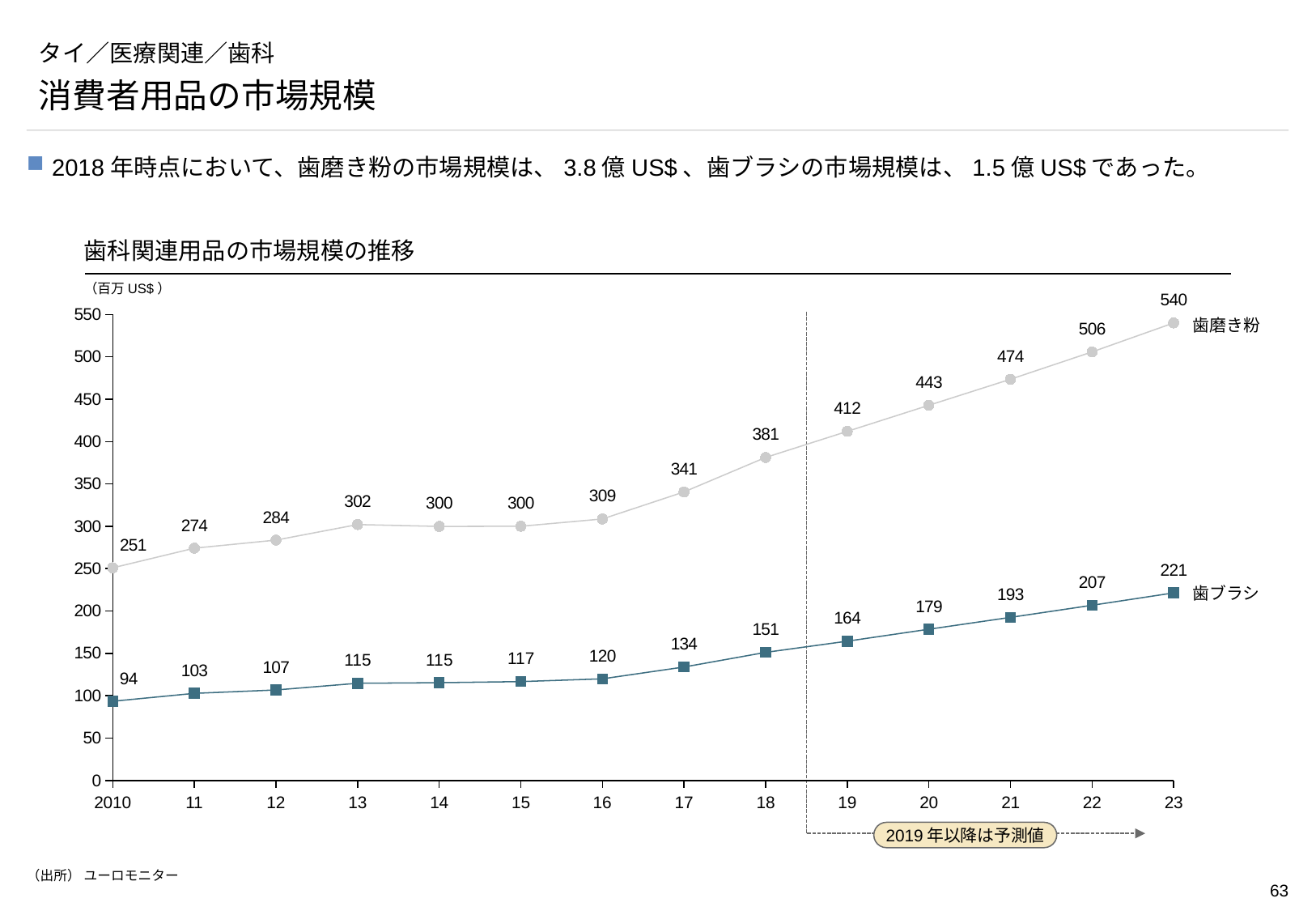
In which year is the 歯磨き粉 series highest? 2023 Which is larger in 2015, 歯磨き粉 or 歯ブラシ? 歯磨き粉 By how much does 歯磨き粉 increase from 2010 to 2023? 289 What is the value for 歯磨き粉 in 2018? 381 What is the value for 歯ブラシ in 2023? 221 What kind of chart is this? line chart What is the unit shown on the chart's y axis? 百万 US$ How many series are plotted on the chart? 2 What is the value for 歯ブラシ in 2010? 94 In which year is the 歯ブラシ series lowest? 2010 How many years are shown on the x axis? 14 What is the difference between 歯磨き粉 and 歯ブラシ in 2018? 230